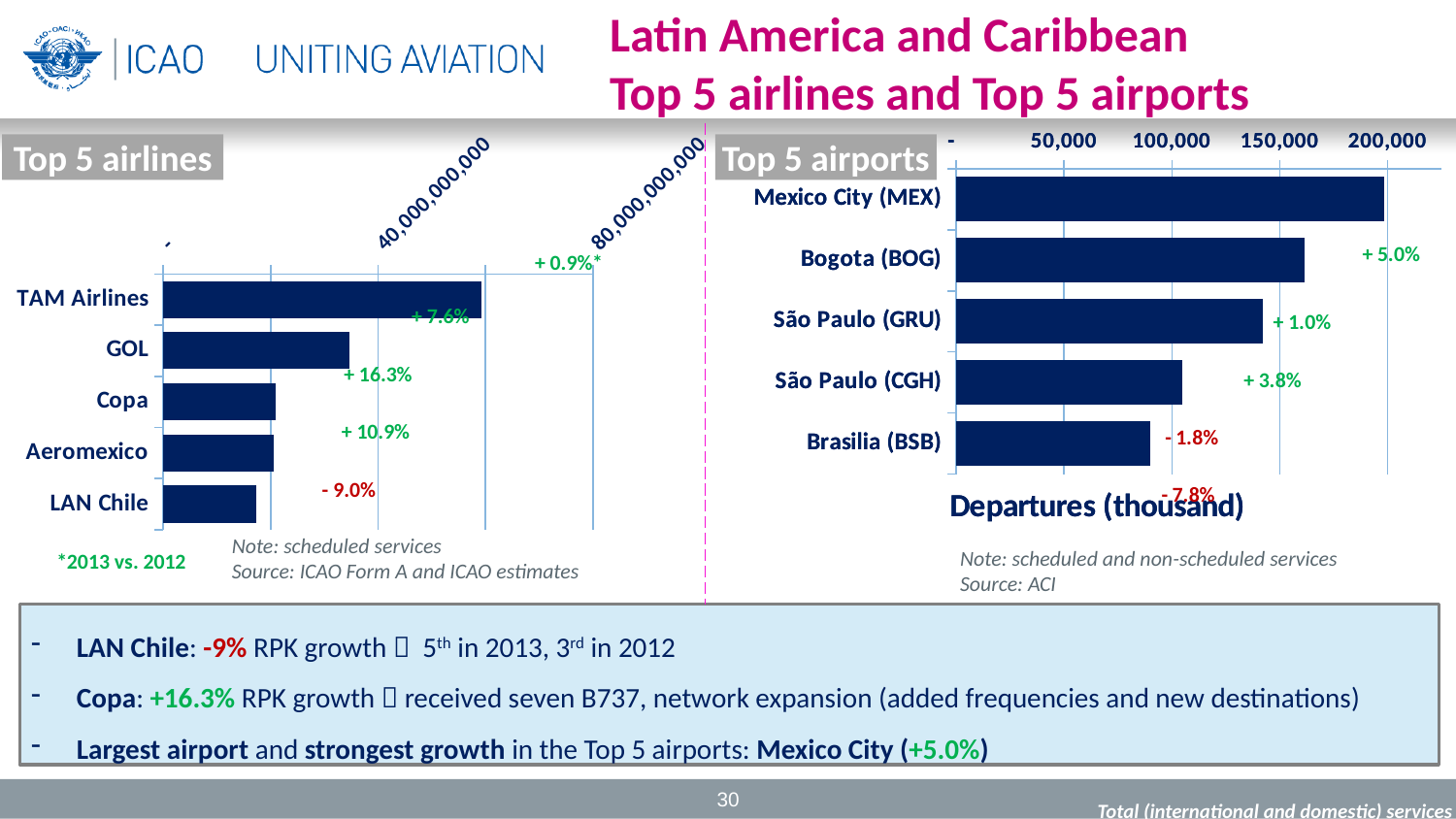
In the Top 5 airlines chart, which airline has the shortest bar? LAN Chile In the Top 5 airports chart, which airport has the fewest departures? Brasilia (BSB) What kind of chart is the Top 5 airlines chart? bar chart In the Top 5 airlines chart, which has the larger value, GOL or Copa? GOL In the Top 5 airports chart, what is the axis label shown below the bars? Departures (thousand) In the Top 5 airlines chart, what growth percentage is shown for Copa? + 16.3% In the Top 5 airports chart, is the value for Bogota (BOG) greater or less than 150,000? greater How many airlines are shown in the Top 5 airlines chart? 5 In the Top 5 airlines chart, is the value for TAM Airlines greater or less than 40,000,000,000? greater In the Top 5 airports chart, which airport has the most departures? Mexico City (MEX) In the Top 5 airlines chart, which airline has the longest bar? TAM Airlines In the Top 5 airlines chart, what growth percentage is shown for LAN Chile? - 9.0%